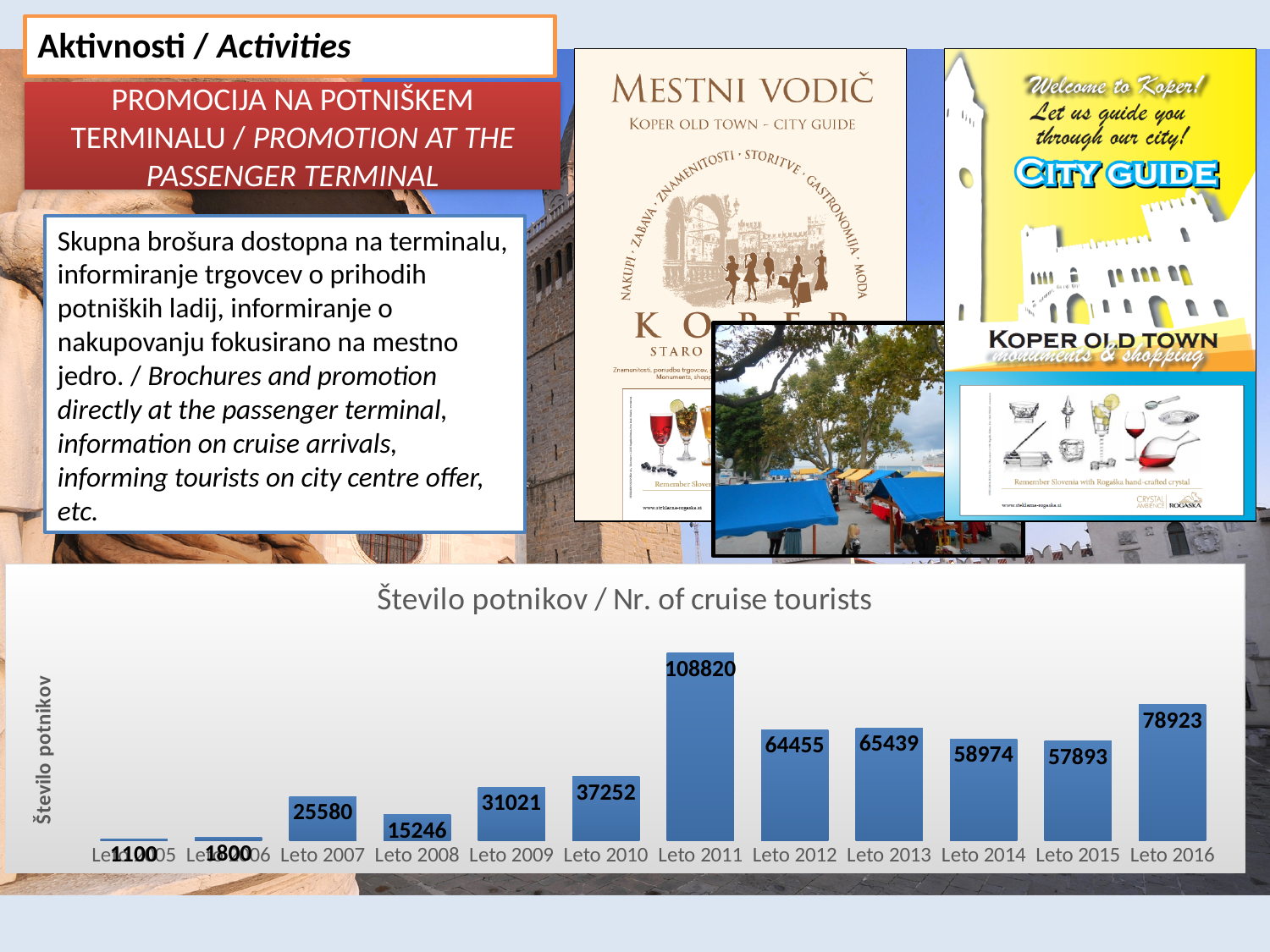
What is the difference between the values for Leto 2011 and Leto 2012? 44365 What is the number of cruise tourists for Leto 2016? 78923 Which year has the lowest number of cruise tourists? Leto 2005 What is the number of cruise tourists for Leto 2011? 108820 What is the difference between the values for Leto 2016 and Leto 2015? 21030 What is the value shown for Leto 2008? 15246 How many years are shown on the chart? 12 What is the value shown for Leto 2014? 58974 Which year has the larger value, Leto 2012 or Leto 2013? Leto 2013 Which year has the highest number of cruise tourists? Leto 2011 Does the number of cruise tourists rise or fall from Leto 2007 to Leto 2008? Fall What kind of chart is used to show the number of cruise tourists? Bar chart